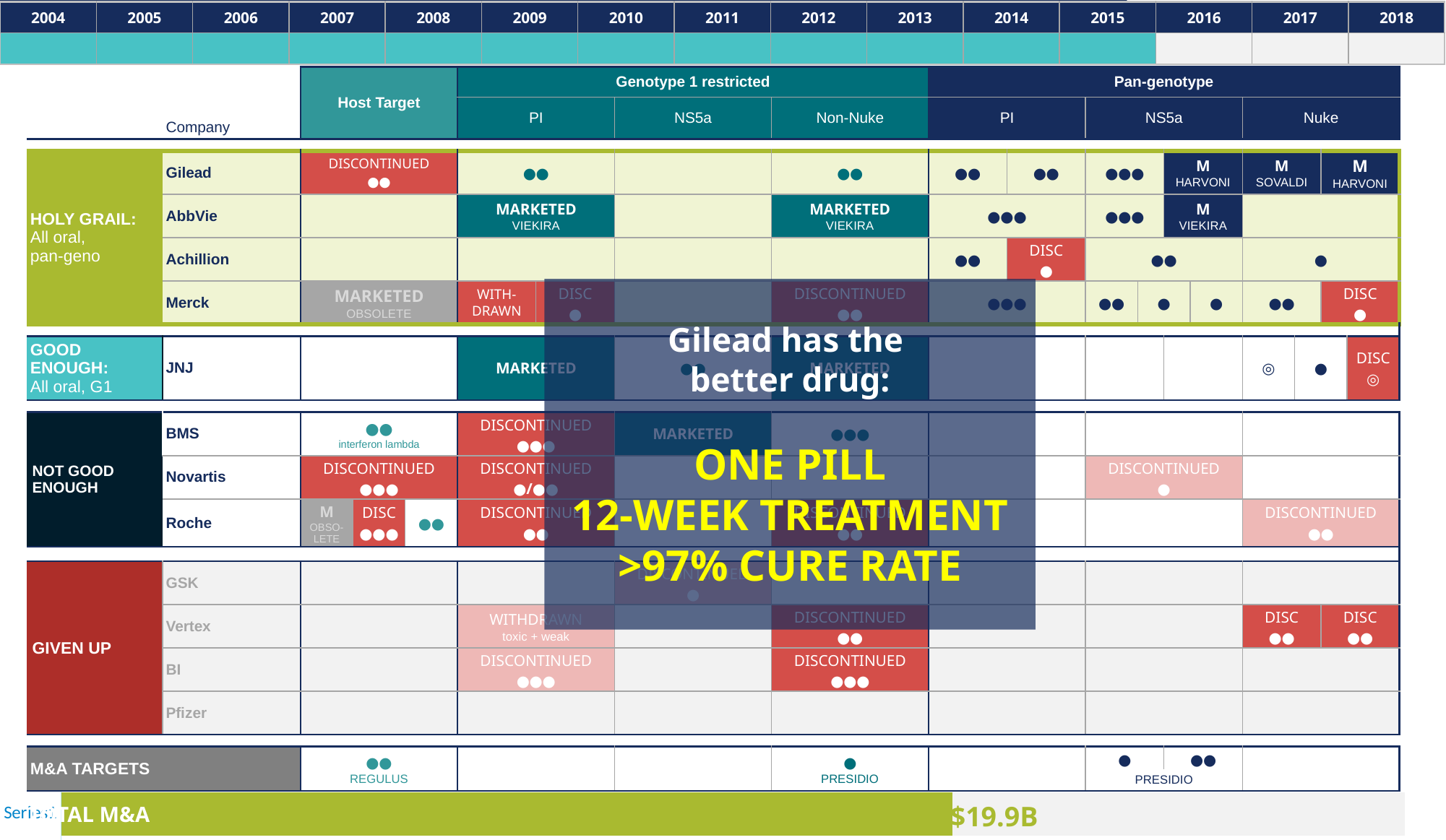
What kind of chart is the TOTAL M&A graphic at the bottom of the slide? bar chart What value is printed on the TOTAL M&A bar at the bottom of the slide? $19.9B How many bars does the TOTAL M&A chart at the bottom of the slide show? 1 What series name is shown at the left of the TOTAL M&A bar at the bottom of the slide? Series1 What is the label written on the green bar at the bottom of the slide? TOTAL M&A